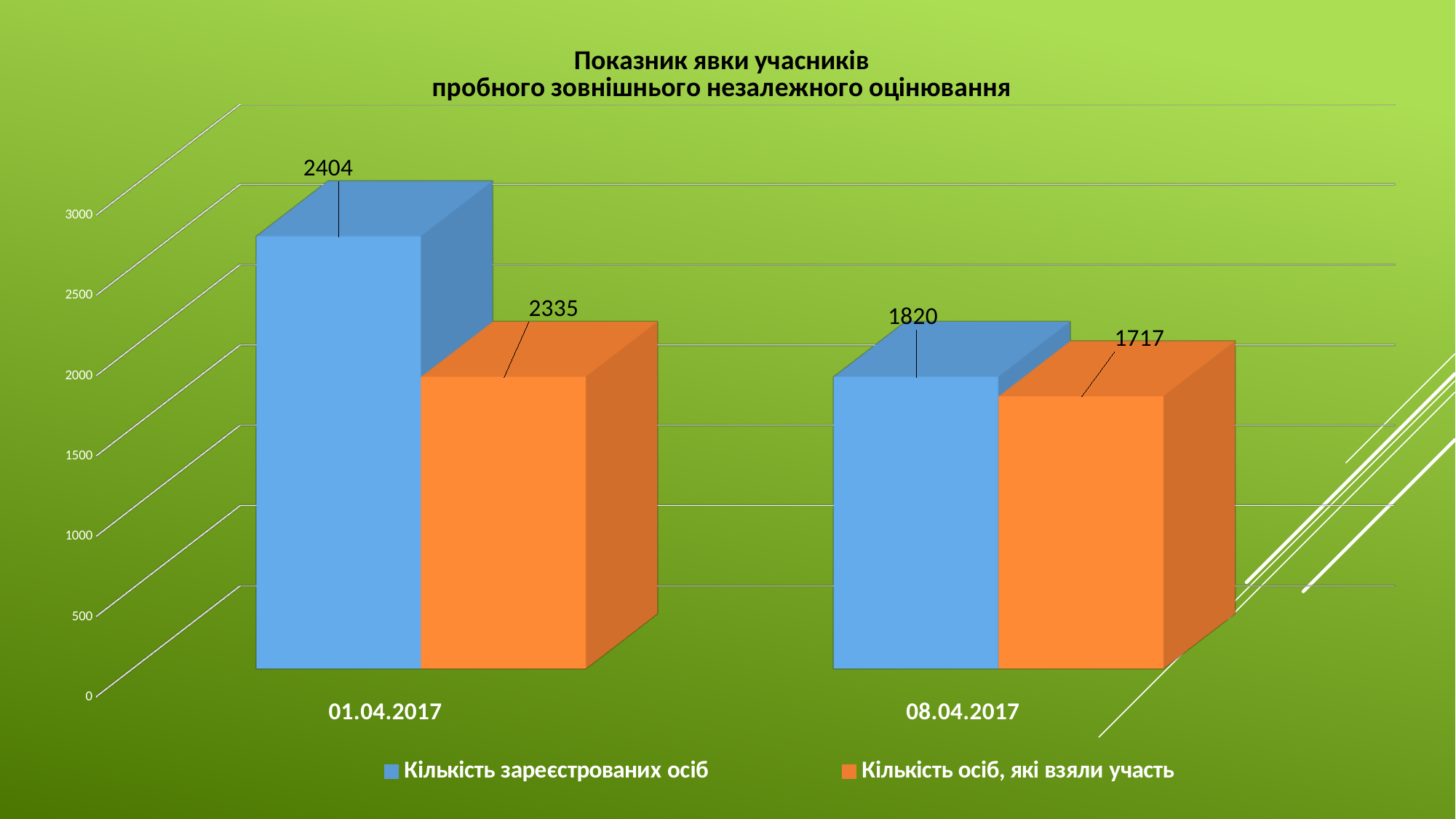
What is the number of registered persons (Кількість зареєстрованих осіб) for 08.04.2017? 1820 What is the difference between registered persons and persons who took part on 08.04.2017? 103 What is the number of registered persons (Кількість зареєстрованих осіб) for 01.04.2017? 2404 Which is larger: the number of persons who took part on 01.04.2017 or the number of registered persons on 08.04.2017? Persons who took part on 01.04.2017 Which date has the lowest number of persons who took part? 08.04.2017 What is the number of persons who took part (Кількість осіб, які взяли участь) for 01.04.2017? 2335 What is the number of persons who took part (Кількість осіб, які взяли участь) for 08.04.2017? 1717 What kind of chart is shown on the slide? Bar chart How many series does the legend list? 2 What is the difference between registered persons and persons who took part on 01.04.2017? 69 How many dates (categories) are shown on the x axis? 2 Which date has the highest number of registered persons? 01.04.2017